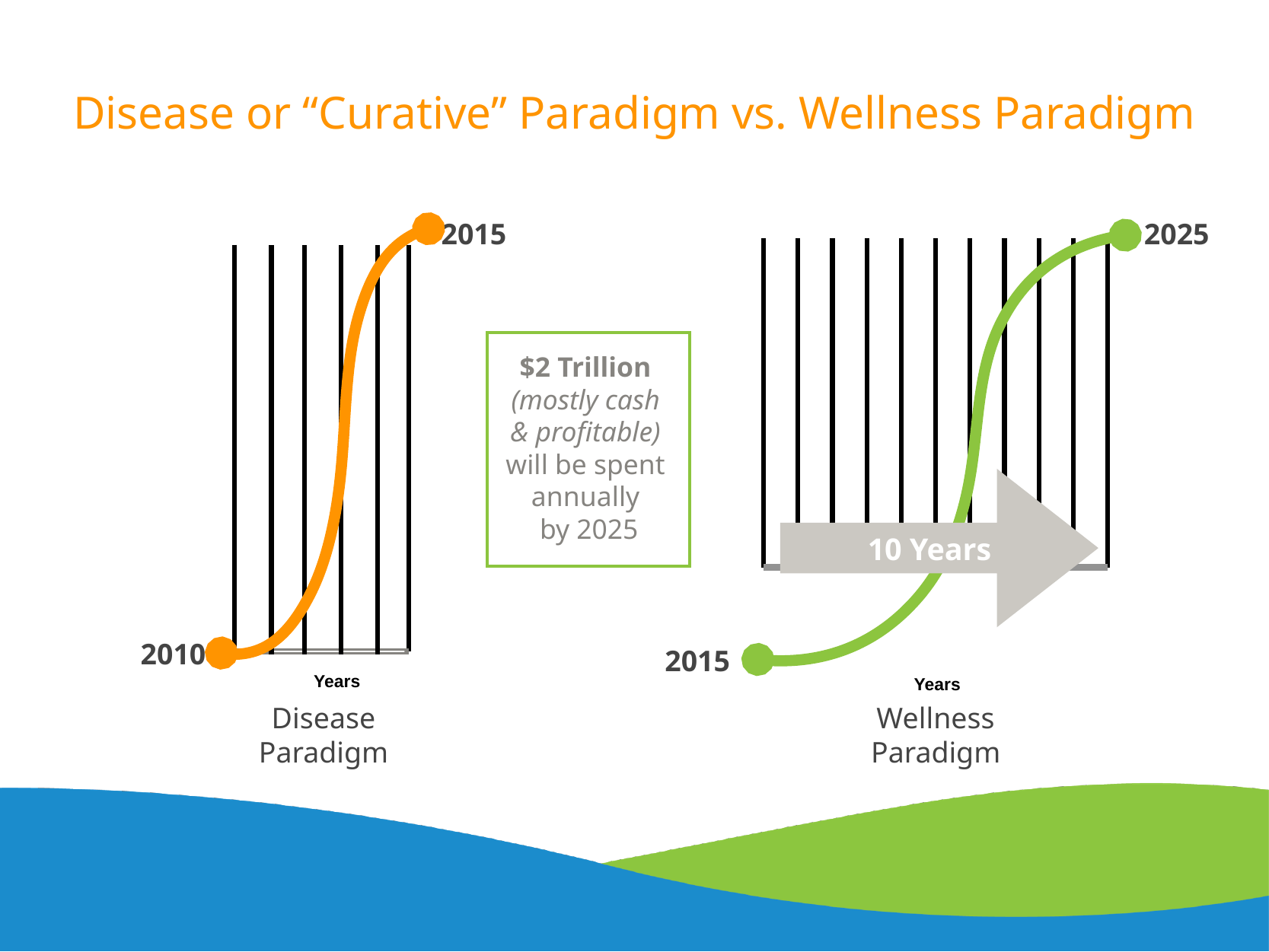
In the Disease Paradigm chart on the left, what year is labelled at the start of the line? 2010 What time span does the arrow in the Wellness Paradigm chart on the right indicate? 10 Years What colour is the line in the Wellness Paradigm chart on the right? green In the Wellness Paradigm chart on the right, what year is labelled at the end of the line? 2025 In the Disease Paradigm chart on the left, what year is labelled at the end of the line? 2015 How many charts are shown on the slide? 2 In the Wellness Paradigm chart on the right, does the line rise or fall from 2015 to 2025? rise What is the x-axis label of the Disease Paradigm chart on the left? Years In the Wellness Paradigm chart on the right, what year is labelled at the start of the line? 2015 In the Disease Paradigm chart on the left, does the line rise or fall from 2010 to 2015? rise